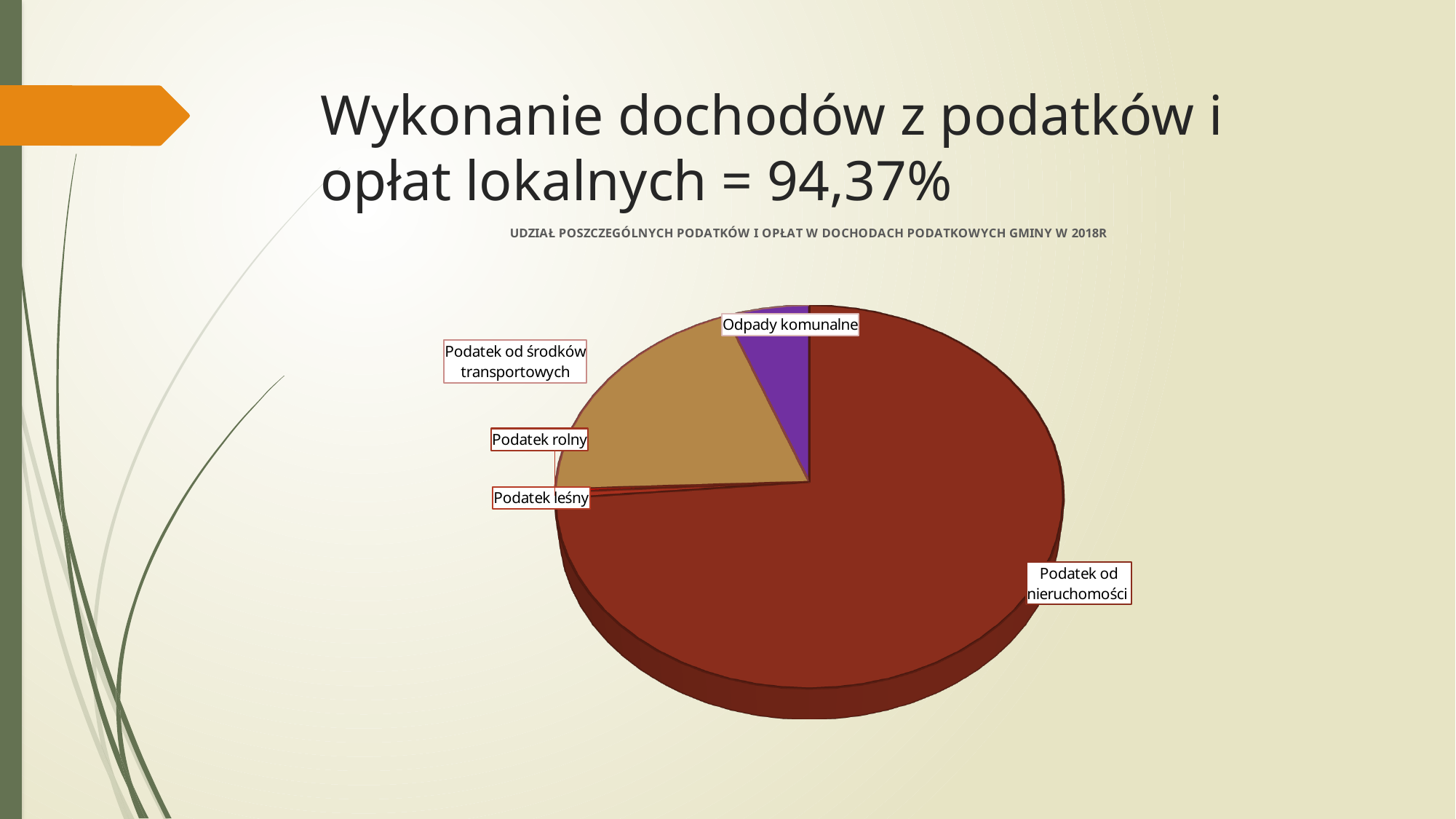
Does the slice for Podatek od nieruchomości make up more or less than half of the pie? more Which slice is larger: Podatek od nieruchomości or Odpady komunalne? Podatek od nieruchomości What is the title of the chart? UDZIAŁ POSZCZEGÓLNYCH PODATKÓW I OPŁAT W DOCHODACH PODATKOWYCH GMINY W 2018R Which category has the largest slice in the pie chart? Podatek od nieruchomości How many categories (slices) are labelled in the pie chart? 5 What kind of chart is shown on the slide? pie chart What colour is the slice for Podatek od nieruchomości? red Which slice is larger: Odpady komunalne or Podatek leśny? Odpady komunalne